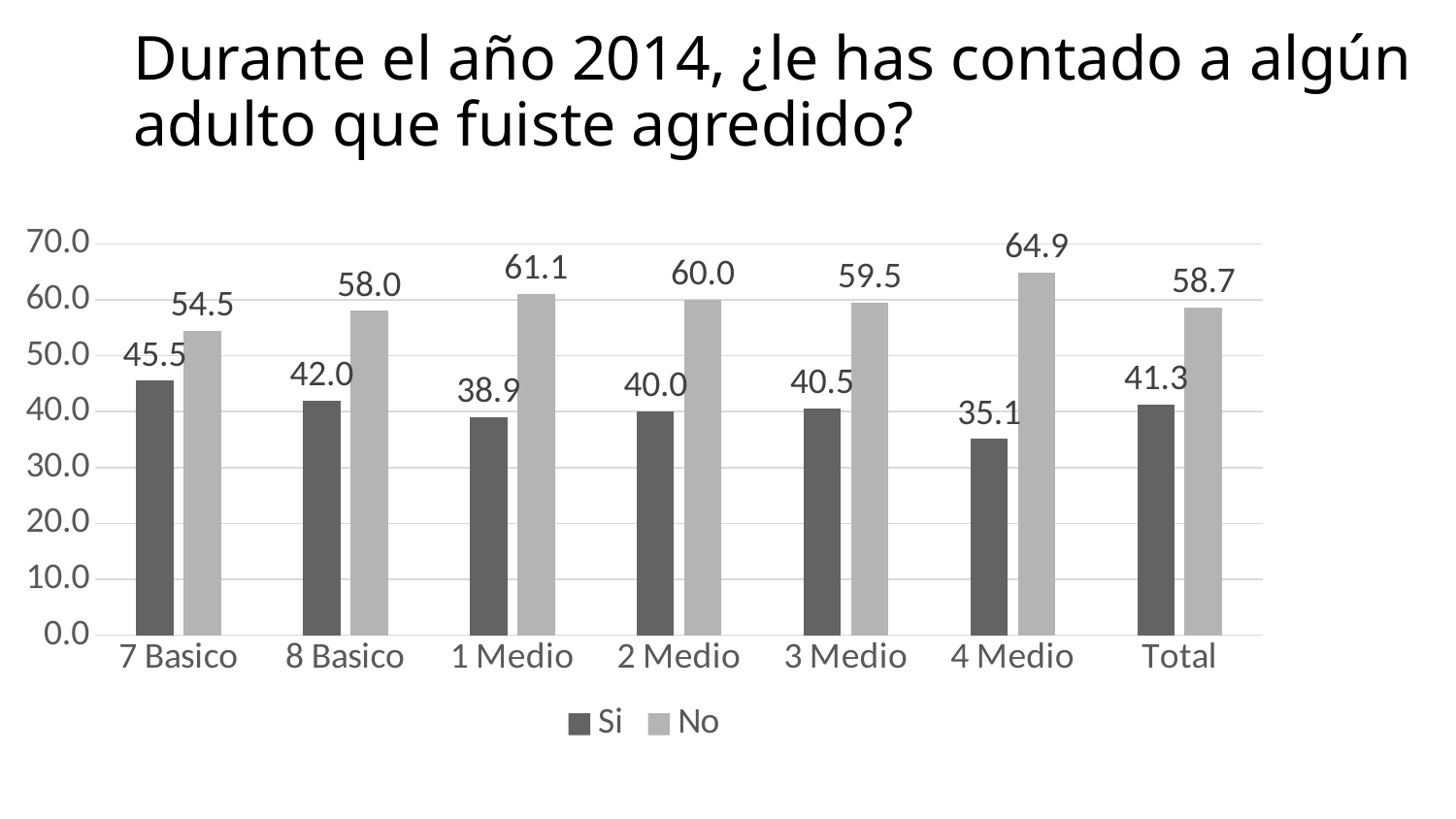
What is the difference between the "No" values for 4 Medio and 7 Basico? 10.4 How many categories are shown on the x axis? 7 Which category has the highest value for the "No" series? 4 Medio Which is larger: the "Si" value for 8 Basico or the "Si" value for 3 Medio? 8 Basico Which series is shown in the darker grey colour? Si What is the value for "Si" in the Total category? 41.3 How many series does the legend list? 2 What is the value for "No" in the 4 Medio category? 64.9 What kind of chart is shown on the slide? Bar chart What is the difference between the "No" and "Si" values for 2 Medio? 20.0 What is the value for "Si" in the 7 Basico category? 45.5 Which category has the lowest value for the "Si" series? 4 Medio